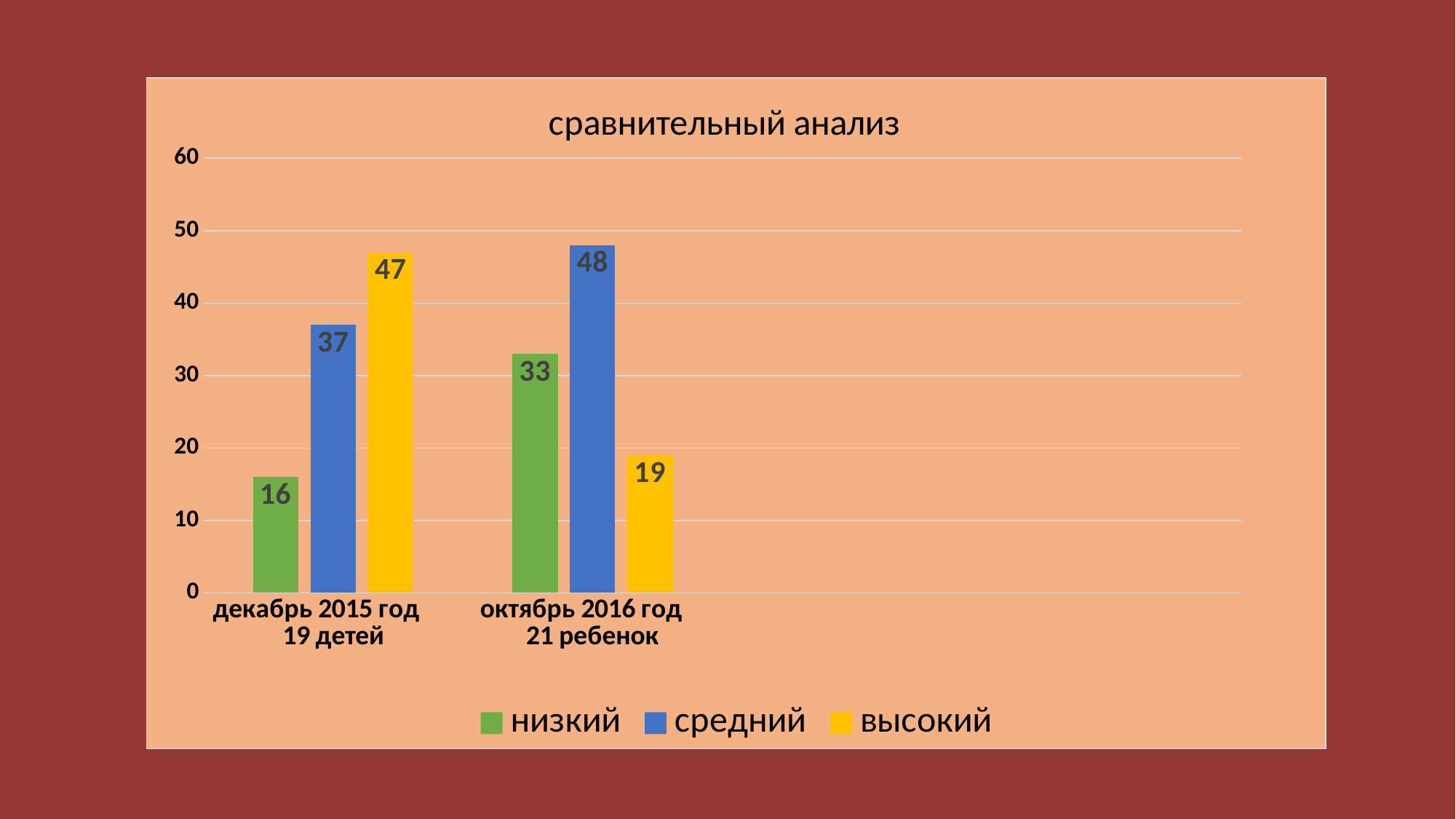
What is the value for средний in октябрь 2016 год 21 ребенок? 48 What is the difference between the средний values for октябрь 2016 год 21 ребенок and декабрь 2015 год 19 детей? 11 Which series has the highest value in декабрь 2015 год 19 детей? высокий What is the value for высокий in декабрь 2015 год 19 детей? 47 Which is larger: низкий in декабрь 2015 год 19 детей or низкий in октябрь 2016 год 21 ребенок? октябрь 2016 год 21 ребенок Which series has the lowest value in октябрь 2016 год 21 ребенок? высокий What kind of chart is shown on the slide? bar chart What is the value for высокий in октябрь 2016 год 21 ребенок? 19 How many categories are shown on the x axis? 2 How many series does the legend list? 3 What is the value for низкий in декабрь 2015 год 19 детей? 16 What is the title of the chart? сравнительный анализ